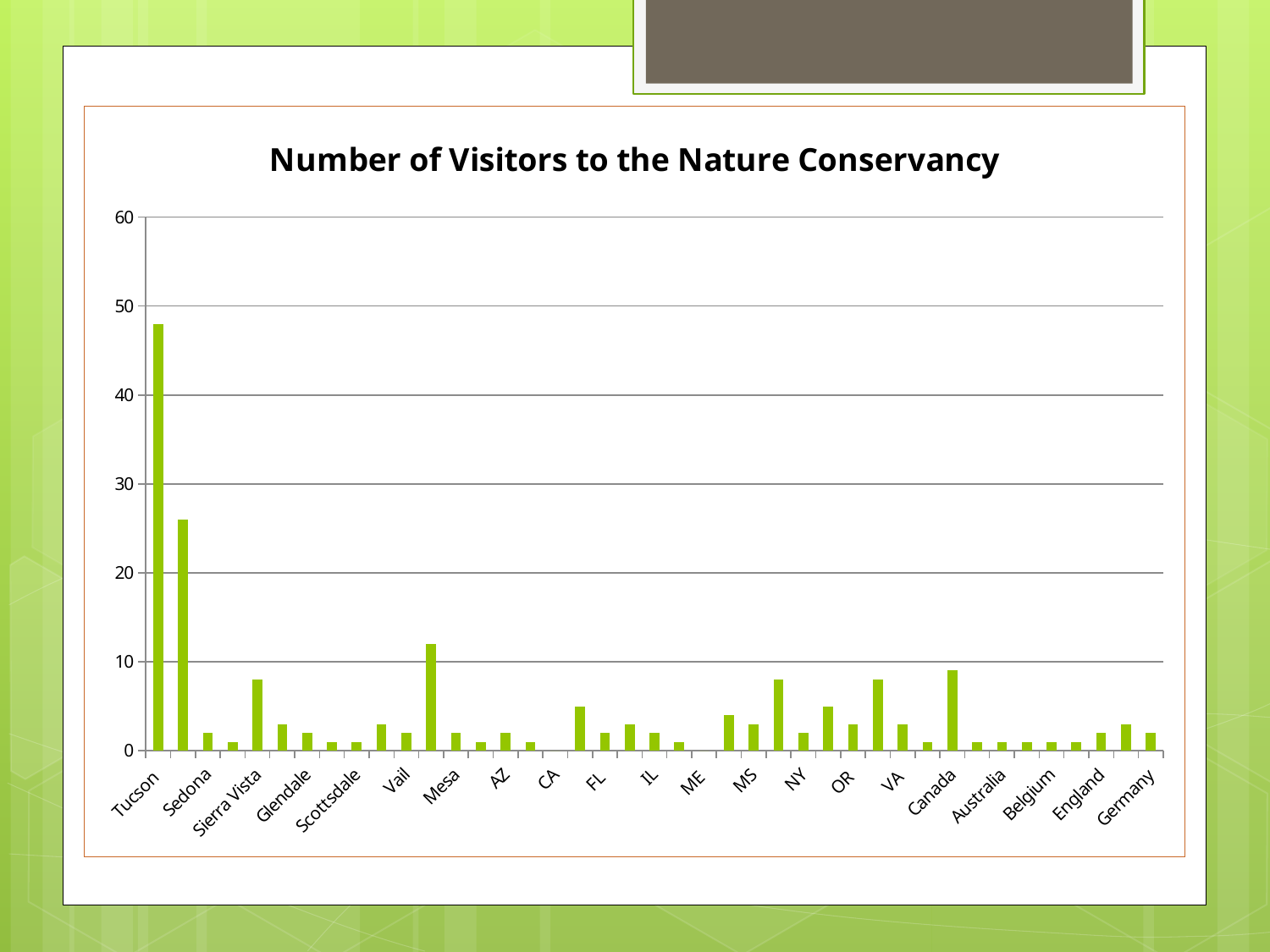
Which category has the highest number of visitors? Tucson Is the value for Tucson greater or less than 40? greater Is the value for Tucson greater or less than 50? less What kind of chart is shown on the slide? bar chart What is the title of the chart? Number of Visitors to the Nature Conservancy What is the highest value shown on the vertical axis? 60